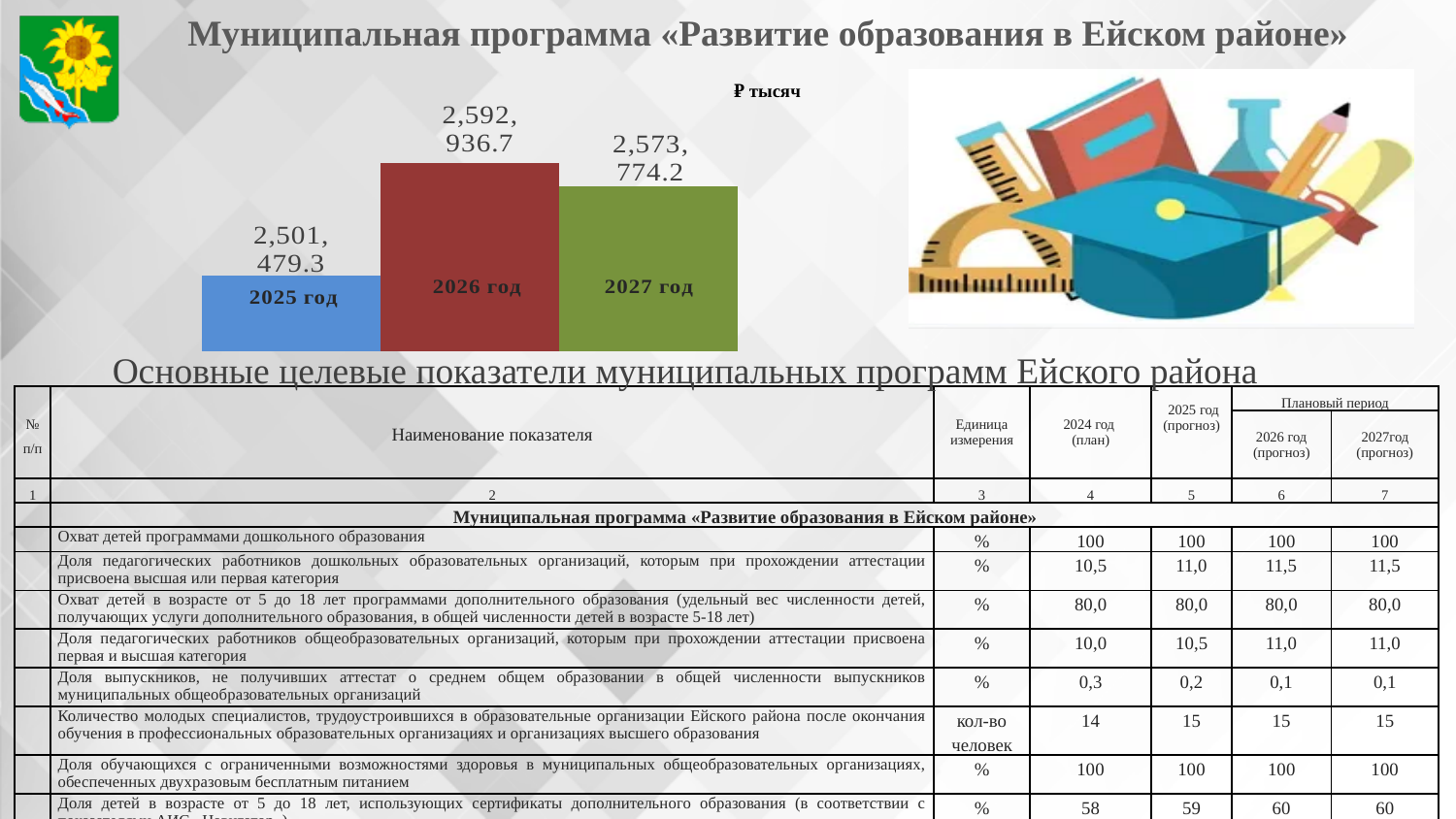
Do the values rise or fall from 2026 год to 2027 год? fall What is the value shown for 2026 год? 2,592,936.7 How many bars (years) does the chart show? 3 Which year has the lowest value in the chart? 2025 год What unit label is shown above the chart? ₽ тысяч What is the value shown for 2025 год? 2,501,479.3 What is the difference between the values for 2026 год and 2027 год? 19,162.5 Which is larger, the value for 2027 год or the value for 2025 год? 2027 год What is the difference between the values for 2026 год and 2025 год? 91,457.4 What type of chart is shown on the slide? bar chart Which year has the highest value in the chart? 2026 год What is the value shown for 2027 год? 2,573,774.2